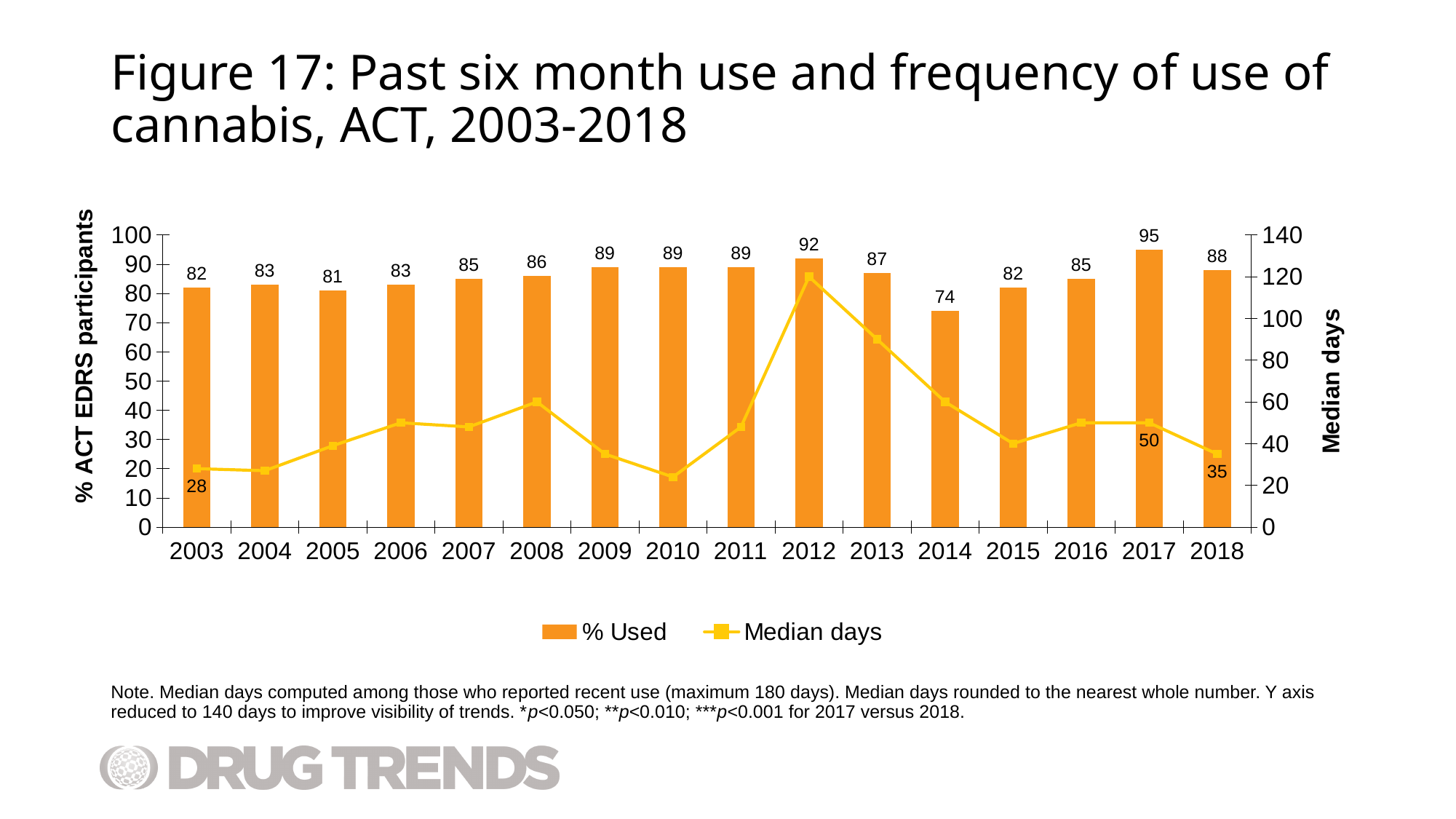
Which year has the lowest % Used value? 2014 What is the Median days value for 2003? 28 Which year has the highest % Used value? 2017 Is the Median days value for 2012 greater or less than 100? greater What is the difference in Median days between 2017 and 2018? 15 What is the % Used value for 2014? 74 What is the Median days value for 2017? 50 How many years are shown on the x axis? 16 Which year has a higher % Used value, 2012 or 2013? 2012 What is the % Used value for 2012? 92 What is the difference in % Used between 2017 and 2018? 7 How many series does the legend list? 2